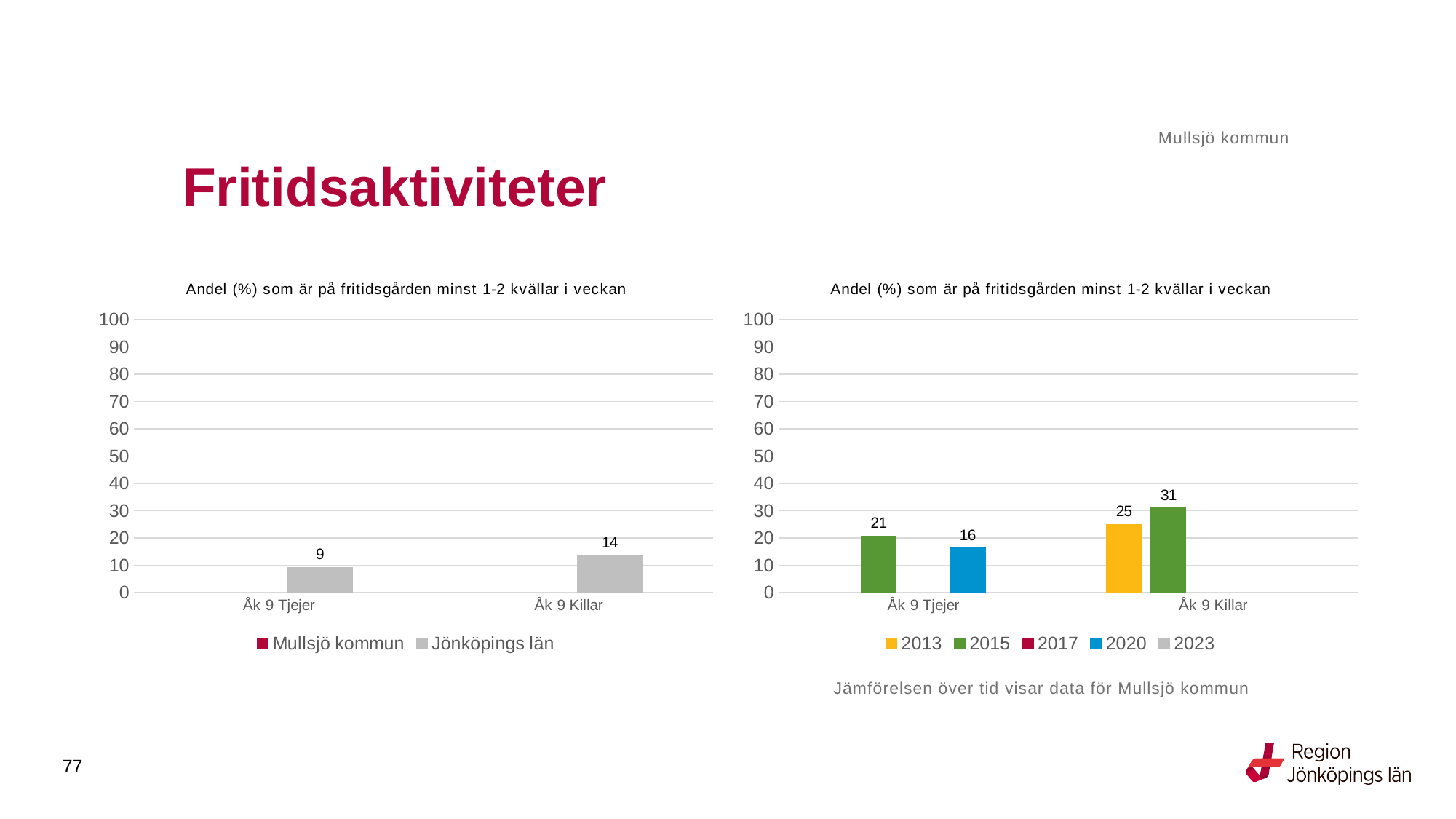
In the left chart, what is the value for Jönköpings län for Åk 9 Killar? 14 In the right chart, what is the value for 2013 for Åk 9 Killar? 25 In the right chart, what is the difference between the 2015 values for Åk 9 Killar and Åk 9 Tjejer? 10 In the left chart, what is the value for Jönköpings län for Åk 9 Tjejer? 9 In the right chart, which year has the highest value for Åk 9 Killar? 2015 In the left chart, what kind of chart is shown? bar chart In the right chart, how many series does the legend list? 5 In the left chart, what is the difference between the Jönköpings län values for Åk 9 Killar and Åk 9 Tjejer? 5 In the right chart, what is the value for 2015 for Åk 9 Tjejer? 21 In the right chart, what is the value for 2015 for Åk 9 Killar? 31 In the left chart, how many series does the legend list? 2 In the right chart, what is the value for 2020 for Åk 9 Tjejer? 16